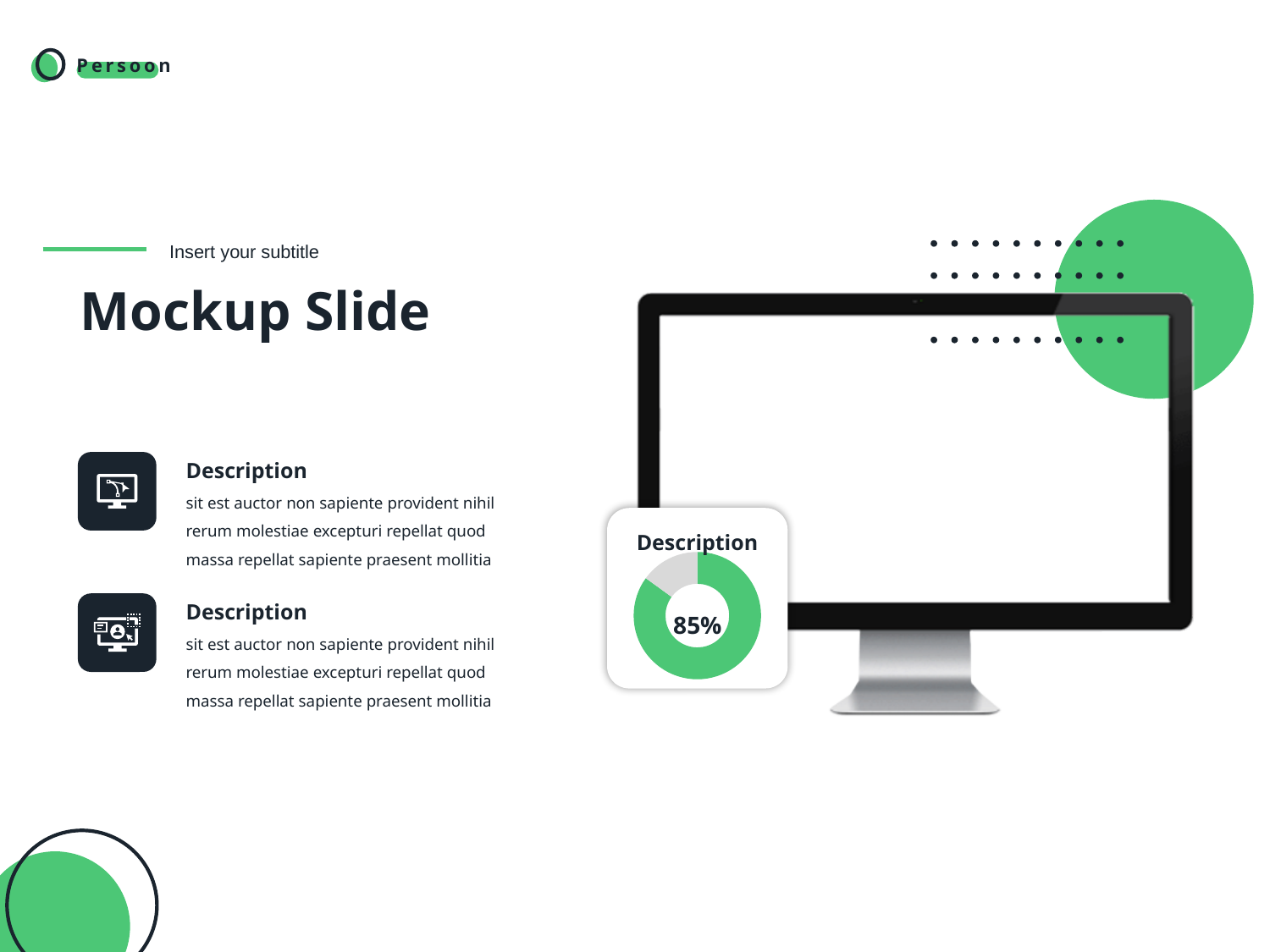
What is the title shown above the donut chart? Description Which slice of the donut chart is larger, the green one or the grey one? The green one How many slices does the donut chart have? 2 What percentage is printed in the centre of the donut chart? 85% What kind of chart is shown on the slide? Donut (pie) chart Is the value shown in the donut chart greater or less than 50%? greater What colour is the slice that represents 85% in the donut chart? Green